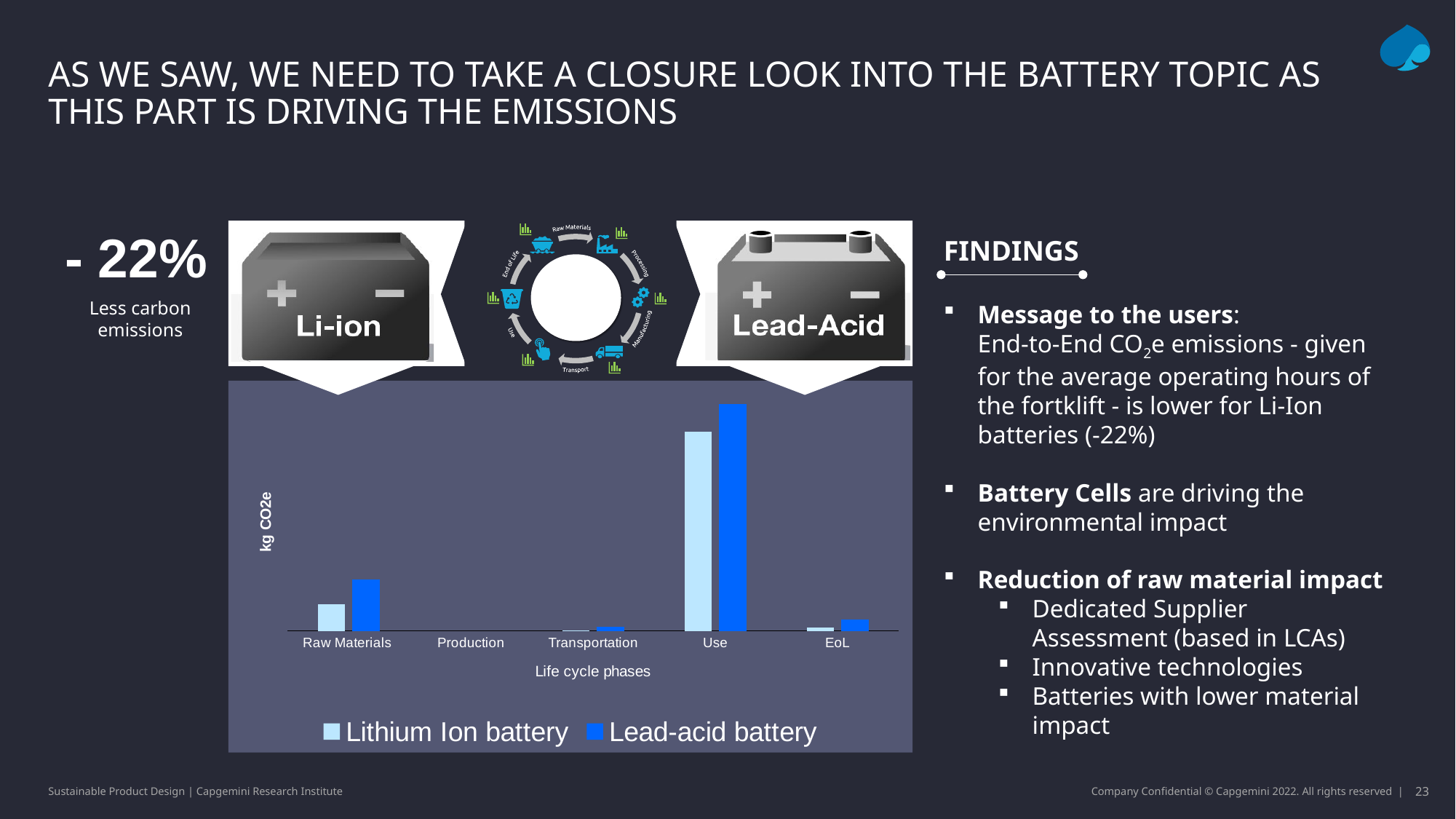
In the Raw Materials phase, which series has the larger value: Lithium Ion battery or Lead-acid battery? Lead-acid battery Which life cycle phase has the highest value for the Lead-acid battery? Use Which life cycle phase has the highest value for the Lithium Ion battery? Use What is the label on the y axis of the chart? kg CO2e In the EoL phase, which series has the larger value: Lithium Ion battery or Lead-acid battery? Lead-acid battery For the Lithium Ion battery, which phase has the larger value: Raw Materials or Use? Use How many series does the chart legend list? 2 What kind of chart is shown on the slide? bar chart What is the label on the x axis of the chart? Life cycle phases How many life cycle phases are shown on the x axis of the chart? 5